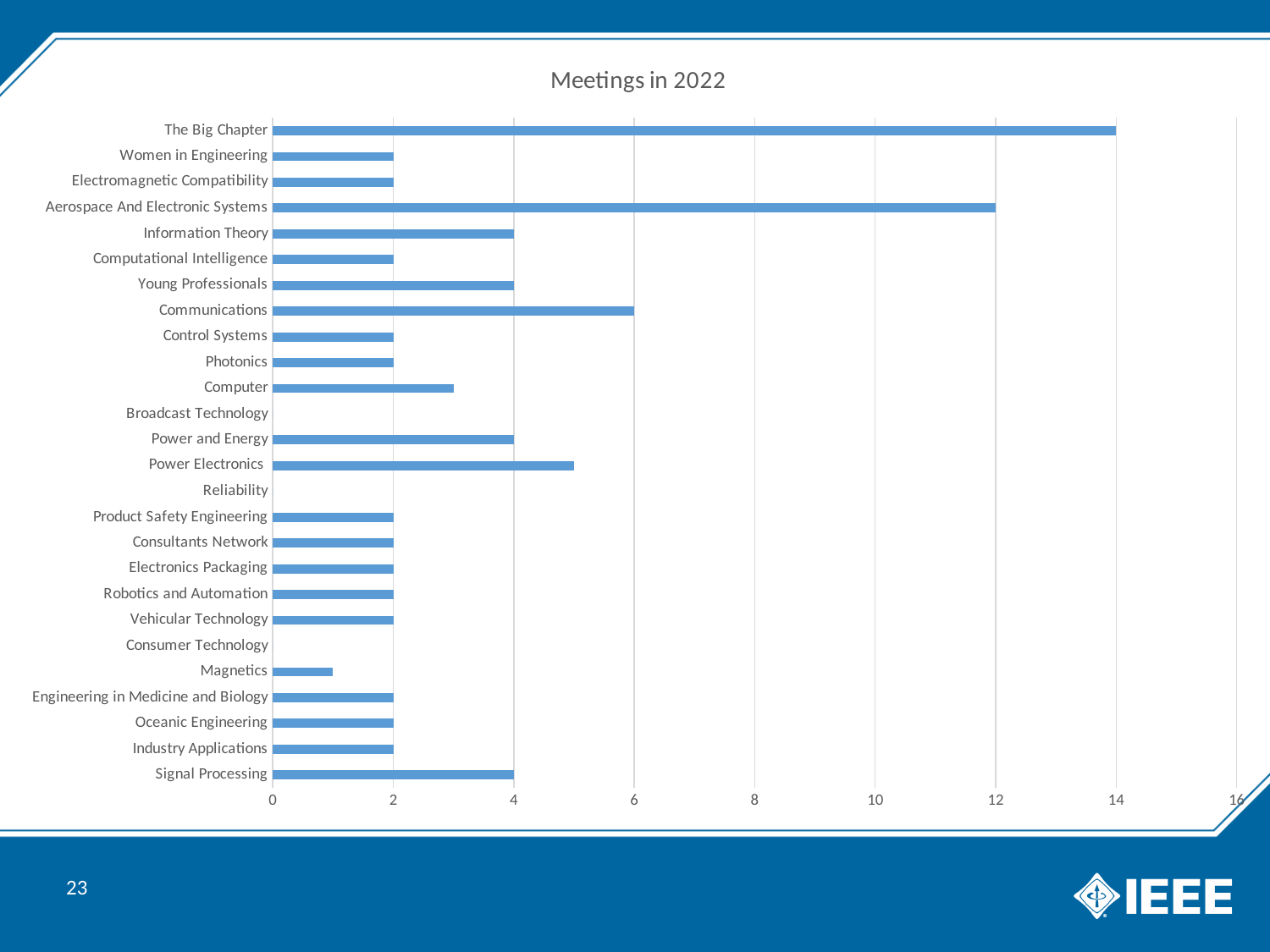
Is the value for Power Electronics greater or less than 4? greater What kind of chart is shown on the slide? bar chart What is the value for Communications? 6 What is the value for Signal Processing? 4 How many categories are shown on the chart? 26 Is the value for Magnetics greater or less than 2? less What is the title of the chart? Meetings in 2022 Which is larger, the value for Aerospace And Electronic Systems or the value for Communications? Aerospace And Electronic Systems What is the value for The Big Chapter? 14 What is the value for Aerospace And Electronic Systems? 12 Which category has the highest value? The Big Chapter What is the difference between the values for The Big Chapter and Aerospace And Electronic Systems? 2